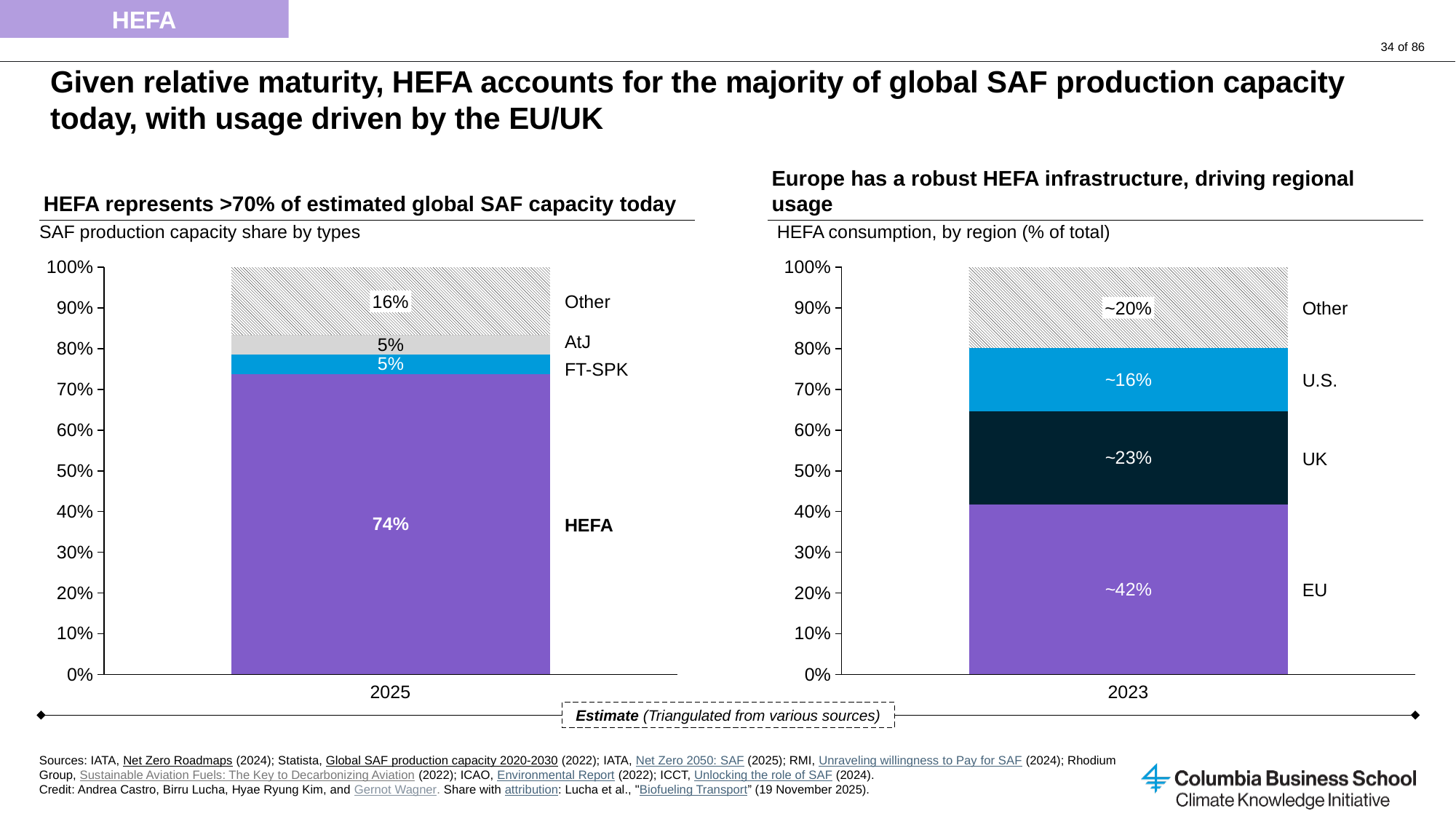
In the left chart (SAF production capacity share by types), how many segments make up the stacked bar? 4 In the right chart (HEFA consumption, by region), what is the value shown for the EU? ~42% In the left chart (SAF production capacity share by types), what share does FT-SPK account for? 5% In the right chart (HEFA consumption, by region), which region has the largest share? EU In the left chart (SAF production capacity share by types), what share does Other account for? 16% In the left chart (SAF production capacity share by types), which type has the largest share? HEFA In the right chart (HEFA consumption, by region), what is the value shown for the U.S.? ~16% In the left chart (SAF production capacity share by types), what share does HEFA account for in 2025? 74% In the right chart (HEFA consumption, by region), which is larger, the UK share or the U.S. share? UK In the right chart (HEFA consumption, by region), what is the value shown for the UK? ~23% In the left chart (SAF production capacity share by types), what is the difference between the HEFA share and the Other share? 58% What kind of chart is the right chart (HEFA consumption, by region)? Stacked bar chart